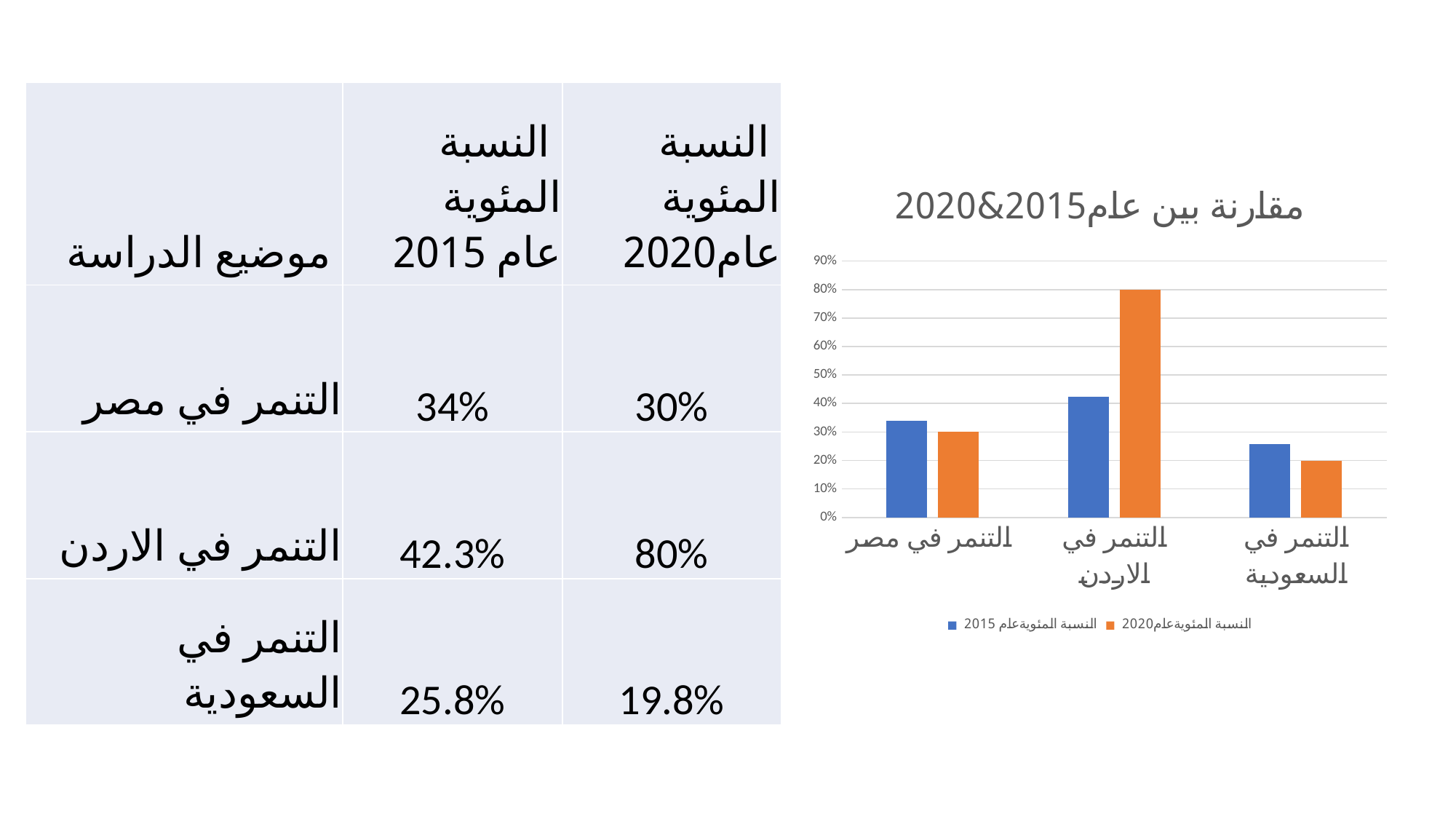
What is the 2020 value for التنمر في مصر in the chart? 30% Is the 2020 value for التنمر في السعودية greater or less than 30%? less How many series does the chart legend list? 2 What kind of chart is shown on the slide? bar chart How many categories are shown on the x axis of the chart? 3 What is the 2020 value for التنمر في الاردن in the chart? 80% What is the difference between the 2020 value for التنمر في الاردن and the 2020 value for التنمر في مصر? 50% What is the title of the chart? مقارنة بين عام2015&2020 For التنمر في الاردن, which is larger in the chart: the 2015 value or the 2020 value? 2020 Which category has the lowest 2015 value in the chart? التنمر في السعودية Which category has the highest 2020 value in the chart? التنمر في الاردن Is the 2015 value for التنمر في الاردن greater or less than 40%? greater